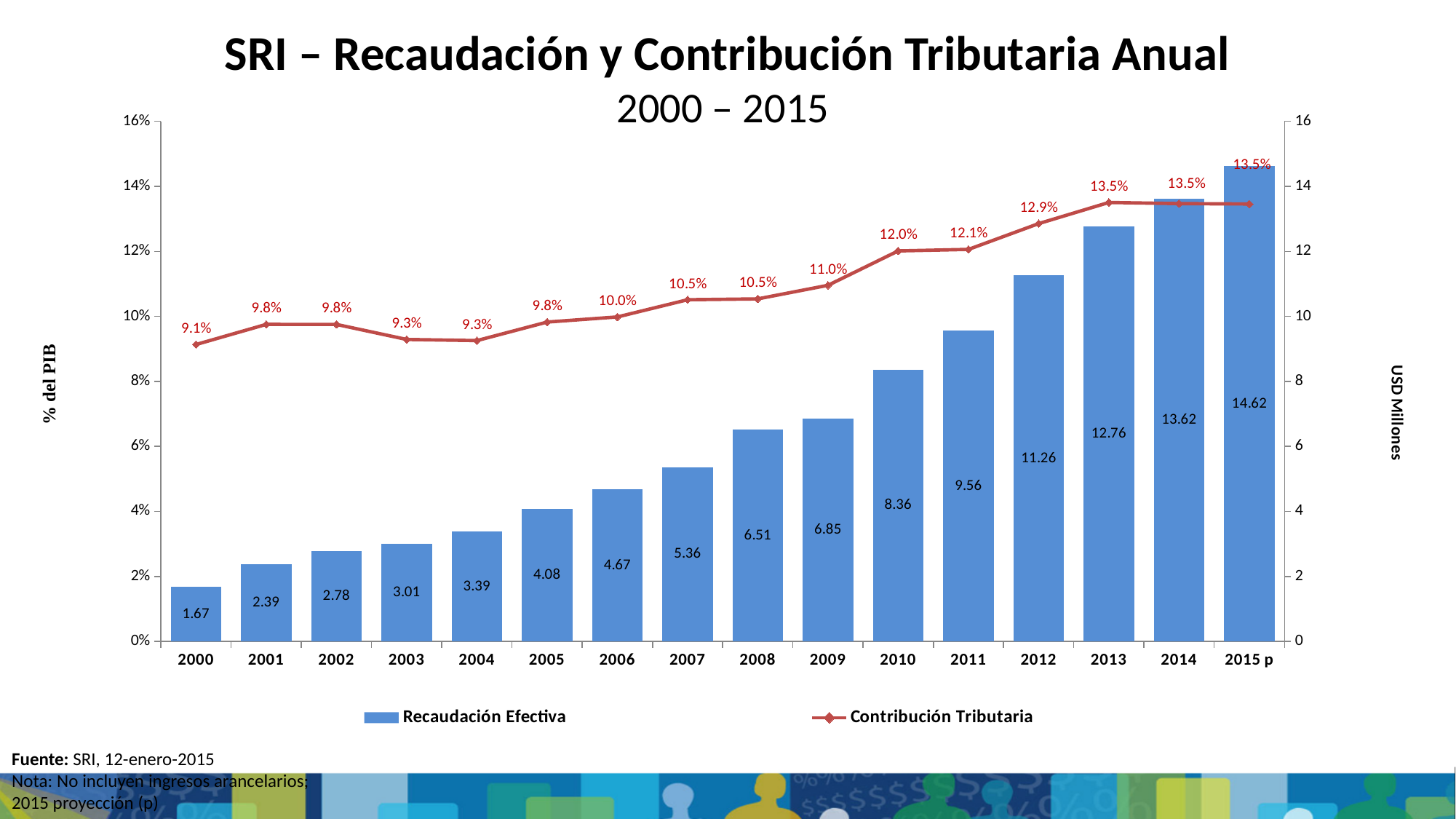
Which year has the highest Recaudación Efectiva? 2015 p Which is larger, the Recaudación Efectiva for 2007 or for 2008? 2008 What is the Recaudación Efectiva value for 2010? 8.36 What is the Recaudación Efectiva value for 2000? 1.67 How many series does the legend list? 2 What is the label of the right-hand vertical axis? USD Millones Do the Recaudación Efectiva values rise or fall from 2000 to 2015 p? Rise Which year has the lowest Contribución Tributaria? 2000 What is the Contribución Tributaria value for 2009? 11.0% How many years are shown on the x axis? 16 What is the difference in Recaudación Efectiva between 2013 and 2012? 1.50 What kind of chart is this? Combined bar and line chart